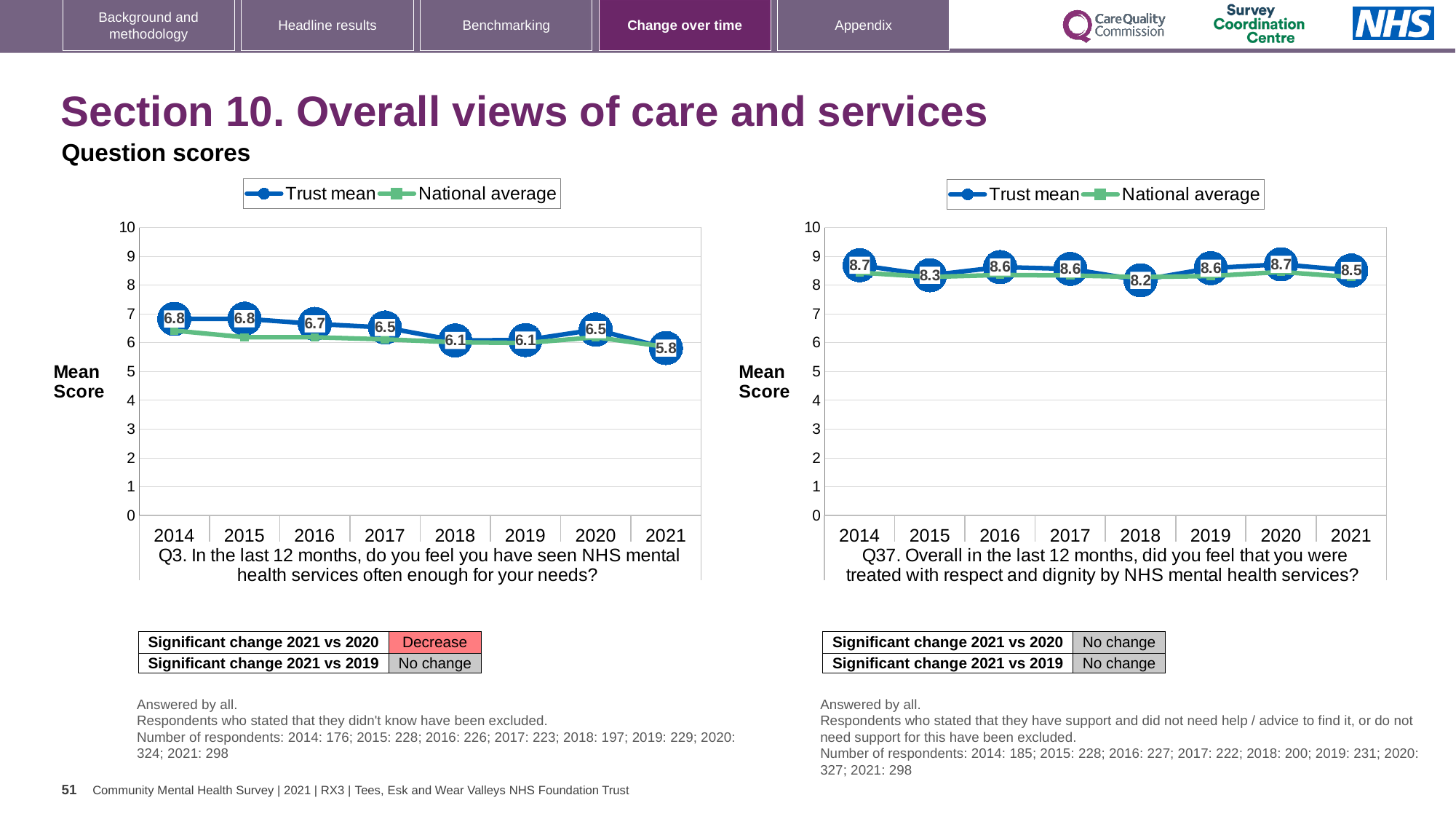
What type of chart is the left chart (Q3)? Line chart In the left chart (Q3), is the Trust mean score higher in 2016 or in 2018? 2016 In the left chart (Q3), does the Trust mean score overall rise or fall from 2014 to 2021? Fall In the right chart (Q37), is the National average value for 2014 greater or less than 8? greater In the right chart (Q37), how many series does the legend list? 2 In the right chart (Q37), which year has the lowest Trust mean score? 2018 In the right chart (Q37), what is the Trust mean score for 2018? 8.2 In the left chart (Q3), what is the difference between the Trust mean scores for 2020 and 2021? 0.7 In the left chart (Q3), how many years are plotted on the x axis? 8 In the right chart (Q37), what is the difference between the Trust mean scores for 2014 and 2018? 0.5 In the left chart (Q3), what is the Trust mean score for 2021? 5.8 In the left chart (Q3), which year has the lowest Trust mean score? 2021